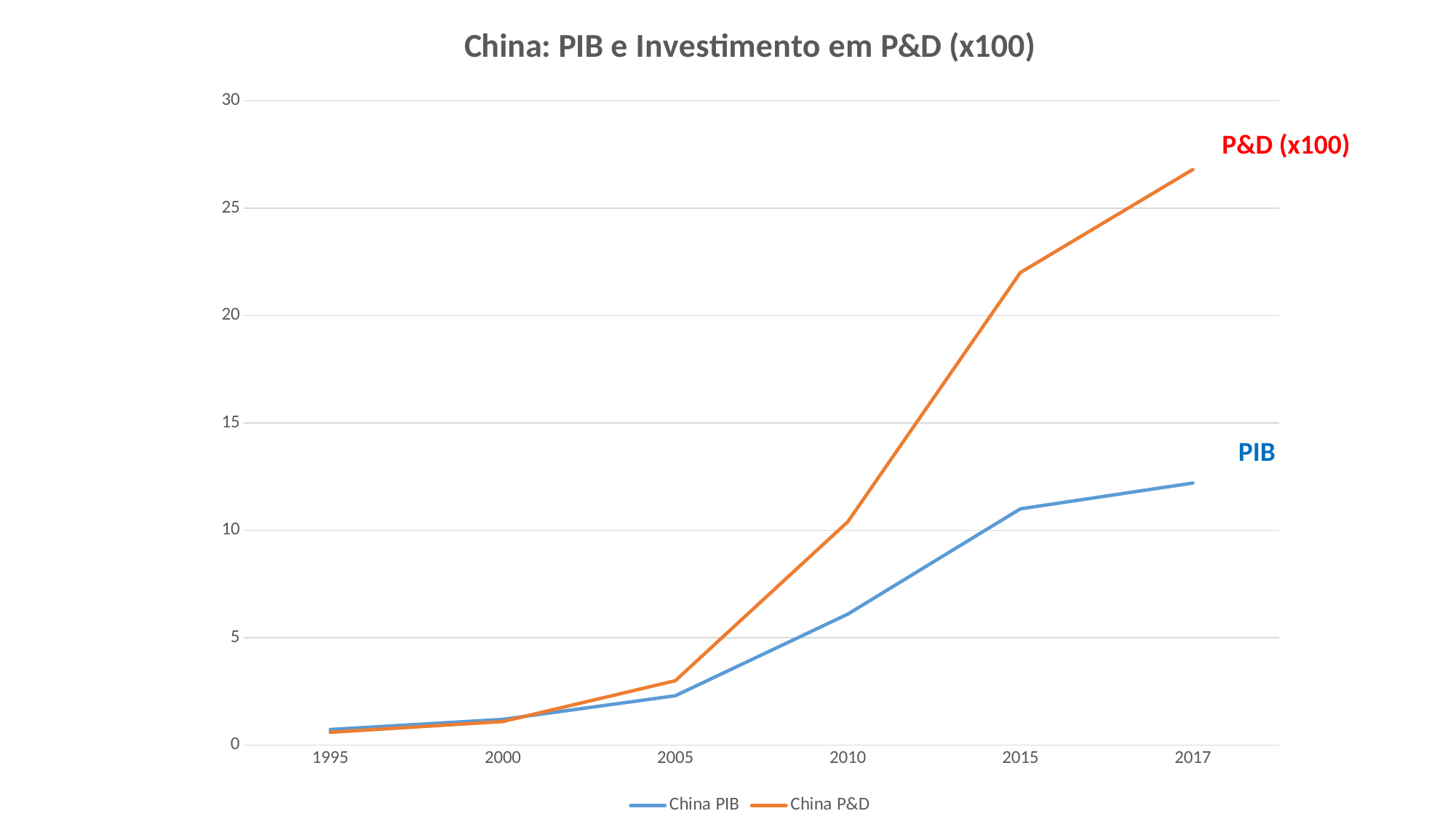
How many series does the legend list? 2 What kind of chart is shown on the slide? Line chart In 2017, which series has the larger value, China PIB or China P&D? China P&D What is the title of the chart? China: PIB e Investimento em P&D (x100) Is the value for China P&D in 2017 greater or less than 25? greater Do the values for China PIB rise or fall from 1995 to 2017? Rise Is the value for China PIB in 2005 greater or less than 5? less Is the value for China P&D in 2005 greater or less than 5? less In which year does the China P&D series reach its highest value? 2017 How many years are shown on the x axis? 6